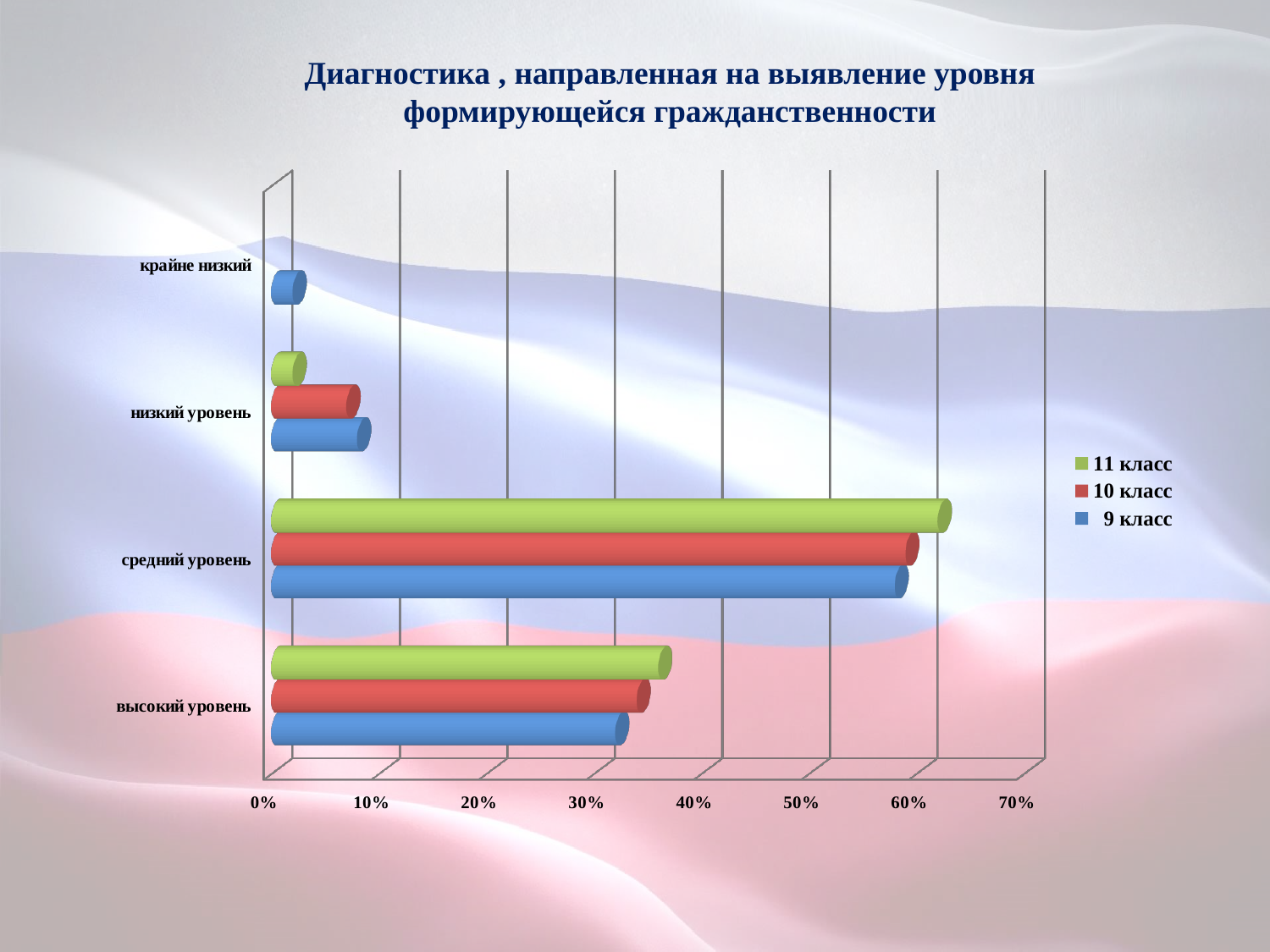
Is the value for 11 класс in средний уровень greater or less than 50%? greater Is the value for 9 класс in низкий уровень greater or less than 20%? less Which category has the highest value for 11 класс? средний уровень In the высокий уровень category, which is larger: 11 класс or 9 класс? 11 класс What kind of chart is shown on the slide? bar chart Is the value for 9 класс in крайне низкий greater or less than 10%? less For 10 класс, which is larger: средний уровень or высокий уровень? средний уровень What colour represents 10 класс in the legend? red How many series does the legend list? 3 Which category has the lowest value for 9 класс? крайне низкий How many categories are shown on the vertical axis? 4